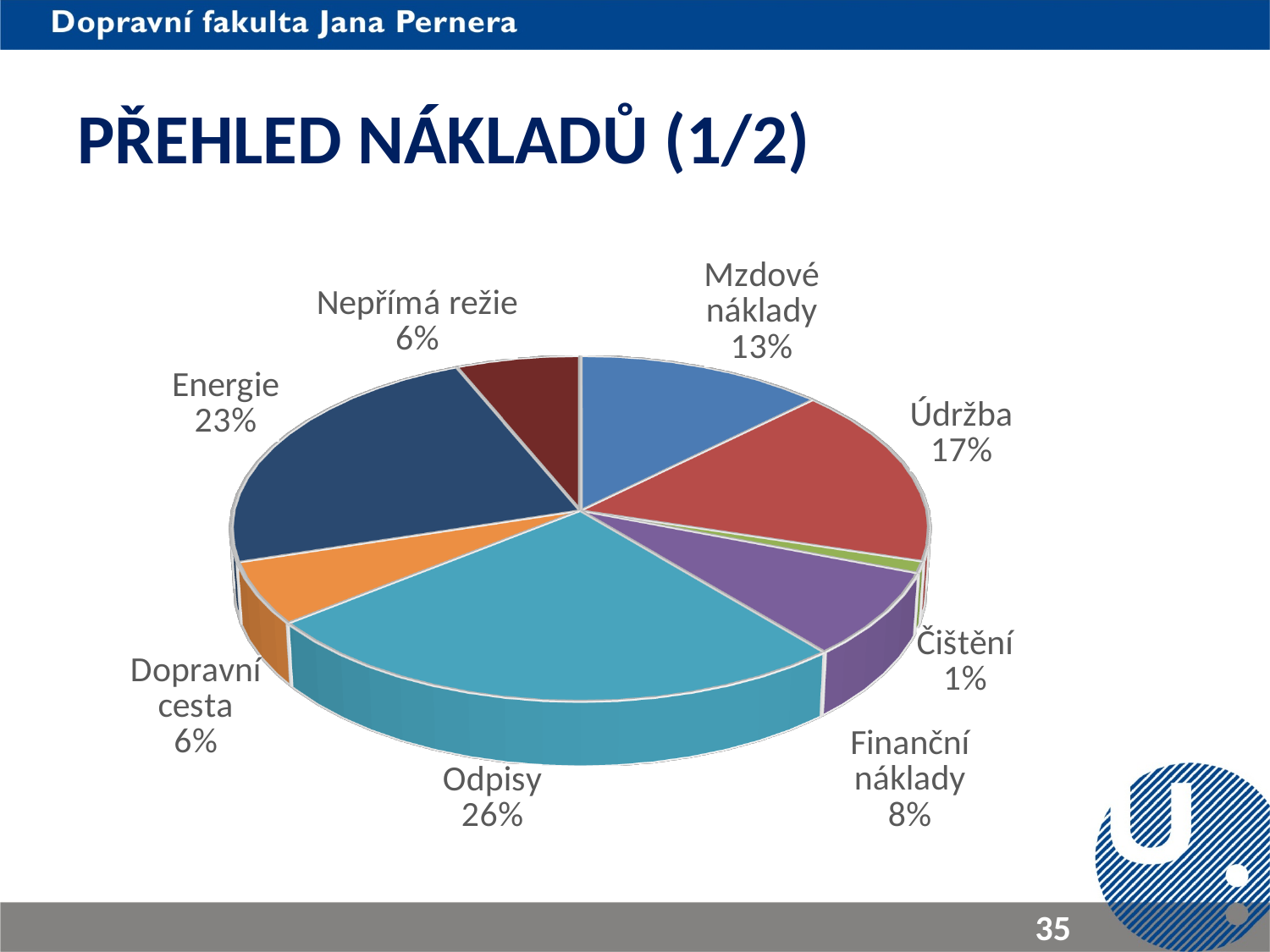
What share of the pie does Odpisy represent? 26% What is the value shown for Finanční náklady? 8% Which is larger, the share for Mzdové náklady or the share for Údržba? Údržba What kind of chart is shown on the slide? pie chart What is the value shown for Údržba? 17% What is the value shown for Energie? 23% Which category has the smallest share of the pie? Čištění What is the title of the slide containing the pie chart? PŘEHLED NÁKLADŮ (1/2) How many slices does the pie chart have? 8 What is the difference between the shares of Mzdové náklady and Finanční náklady? 5% Which category has the largest share of the pie? Odpisy What is the difference between the shares of Odpisy and Energie? 3%